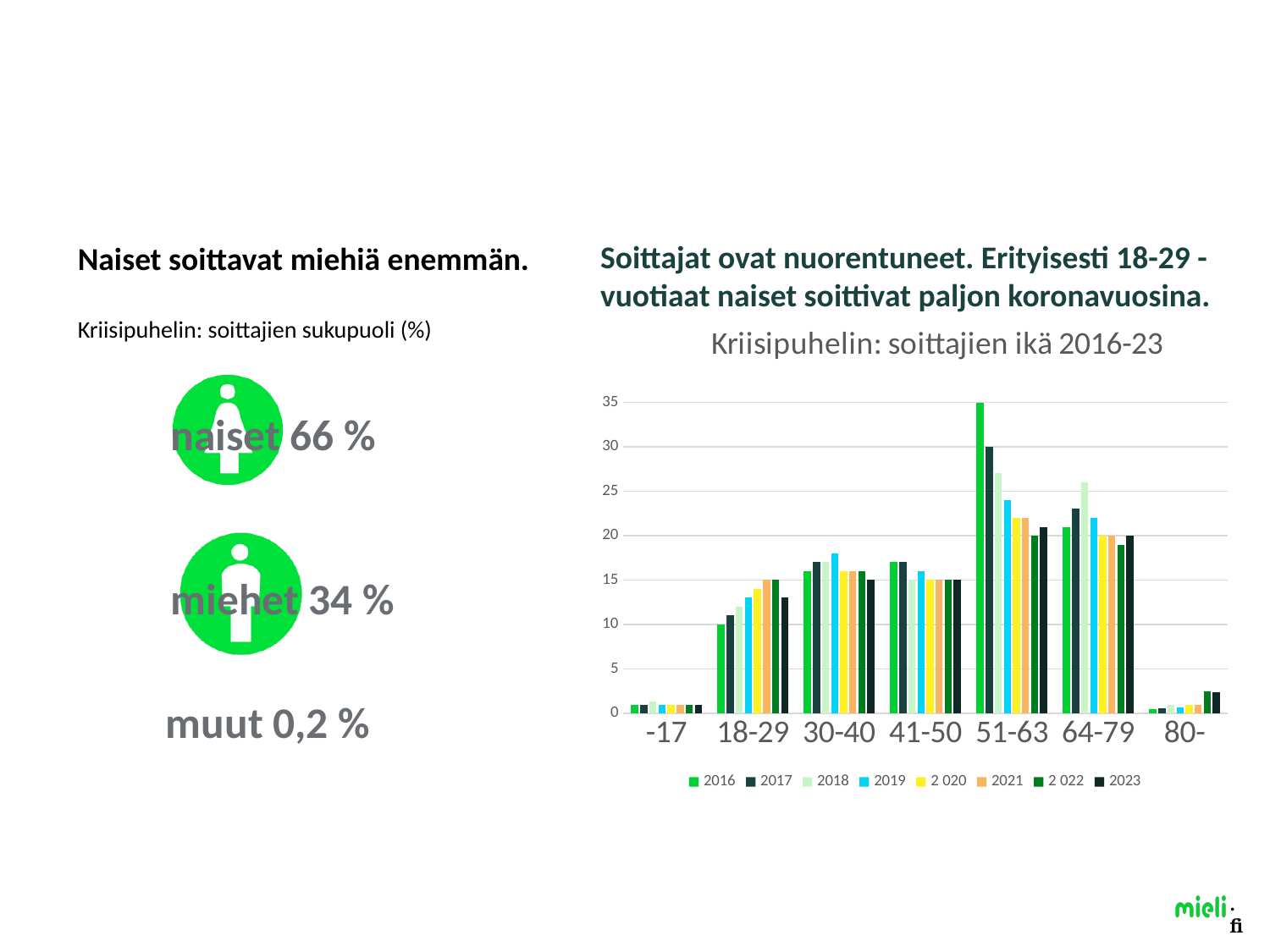
In the age chart, is the 2017 value for 30-40 greater or less than 15? greater In the age chart, which age group has the highest value for 2016? 51-63 In the age chart, which is larger for the 51-63 group: the 2016 value or the 2023 value? 2016 In the age chart, is the 2023 value for 18-29 greater or less than 15? less In the age chart, do the values for the 51-63 group rise or fall from 2016 to 2023? fall How many age groups are shown on the x axis of the age chart? 7 What kind of chart is 'Kriisipuhelin: soittajien ikä 2016-23'? bar chart In the age chart, is the 2016 value for 51-63 greater or less than 30? greater What is the title of the bar chart on the slide? Kriisipuhelin: soittajien ikä 2016-23 How many series does the legend of the age chart list? 8 In the age chart, which is larger for the 18-29 group: the 2016 value or the 2023 value? 2023